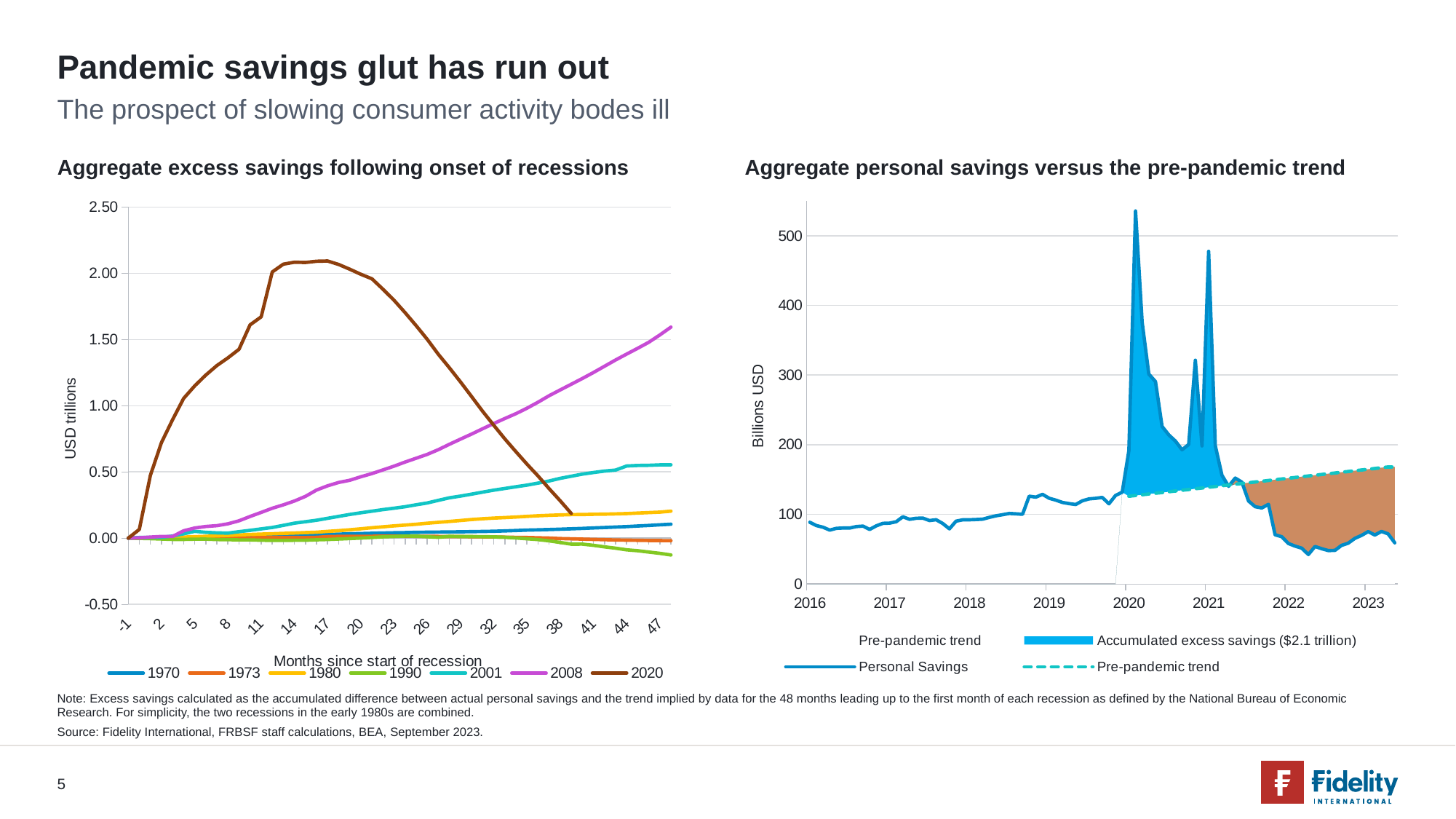
In the chart 'Aggregate excess savings following onset of recessions', how many series does the legend list? 7 In the chart 'Aggregate excess savings following onset of recessions', which series has the lowest value at month 47? 1990 In the chart 'Aggregate excess savings following onset of recessions', which series reaches the highest value? 2020 What is the y-axis label of the chart 'Aggregate excess savings following onset of recessions'? USD trillions In the chart 'Aggregate personal savings versus the pre-pandemic trend', what amount of accumulated excess savings does the legend state? $2.1 trillion In the chart 'Aggregate excess savings following onset of recessions', does the 2020 series rise or fall between month 17 and month 38? fall In the chart 'Aggregate excess savings following onset of recessions', is the peak value of the 2020 series greater or less than 2.00? greater In the chart 'Aggregate excess savings following onset of recessions', which series is higher at month 47, 2008 or 2001? 2008 What kind of chart is 'Aggregate personal savings versus the pre-pandemic trend'? combination area and line chart In the chart 'Aggregate personal savings versus the pre-pandemic trend', does Personal Savings rise or fall from 2021 to 2023? fall In the chart 'Aggregate personal savings versus the pre-pandemic trend', is the highest peak of Personal Savings in 2020 greater or less than 500? greater